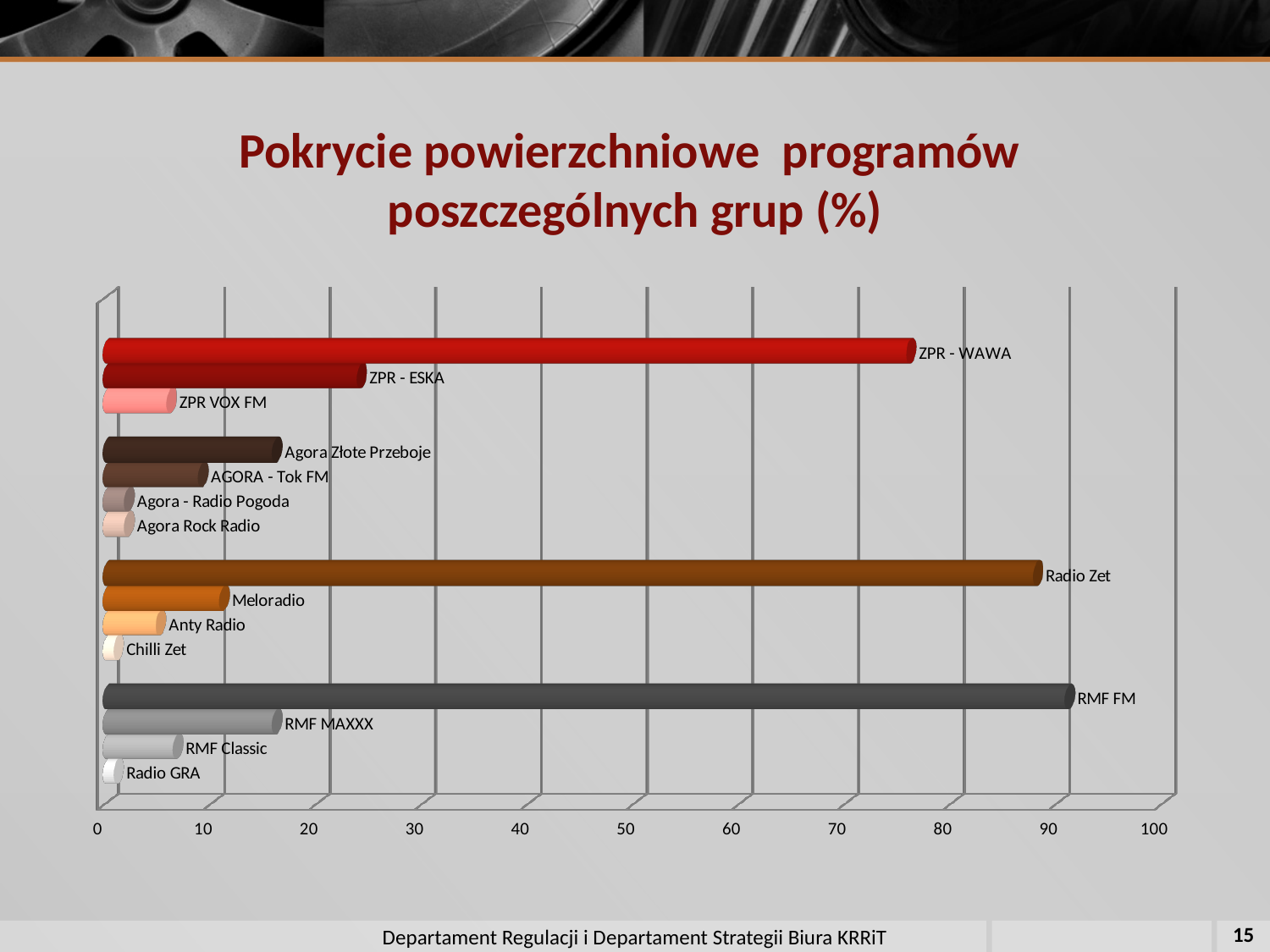
What is the title of the chart on the slide? Pokrycie powierzchniowe programów poszczególnych grup (%) What kind of chart is shown on the slide? bar chart Which radio programme has the highest coverage in the chart? RMF FM Is the value for ZPR VOX FM greater or less than 10? less Is the value for RMF MAXXX greater or less than 20? less Which has the larger value, ZPR - WAWA or ZPR - ESKA? ZPR - WAWA Which has the larger value, Meloradio or Anty Radio? Meloradio Is the value for ZPR - ESKA greater or less than 20? greater How many radio programmes (bars) are plotted in the chart? 15